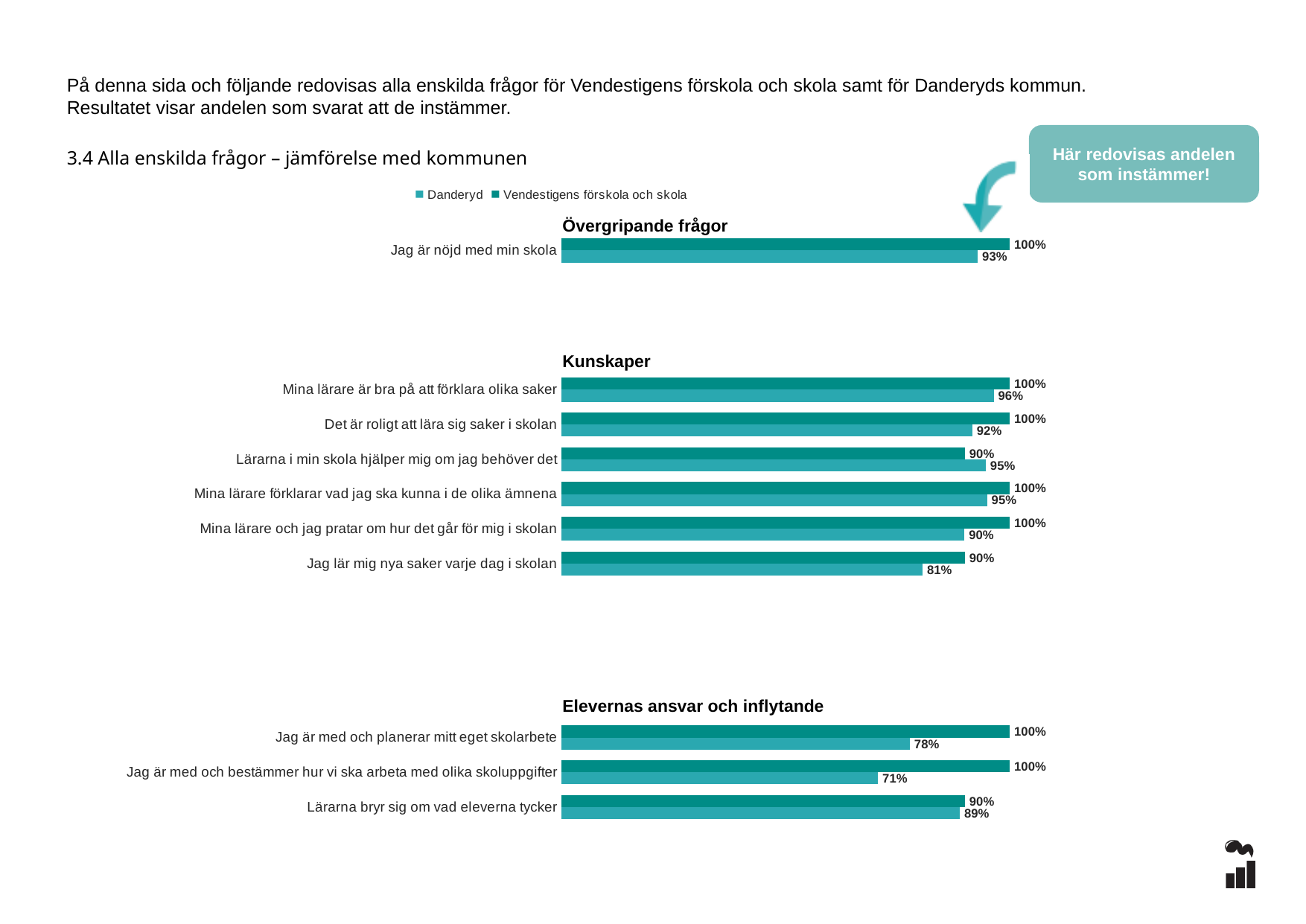
In the 'Elevernas ansvar och inflytande' chart, which question has the lowest Danderyd value? Jag är med och bestämmer hur vi ska arbeta med olika skoluppgifter In the 'Kunskaper' chart, what is the difference between the Vendestigens förskola och skola value and the Danderyd value for 'Jag lär mig nya saker varje dag i skolan'? 9% In the 'Kunskaper' chart, what is the Danderyd value for 'Jag lär mig nya saker varje dag i skolan'? 81% In the 'Elevernas ansvar och inflytande' chart, what is the difference between the Vendestigens förskola och skola value and the Danderyd value for 'Jag är med och planerar mitt eget skolarbete'? 22% In the 'Kunskaper' chart, how many questions are listed? 6 What kind of chart is the 'Kunskaper' chart? Bar chart How many series does the legend list? 2 In the 'Elevernas ansvar och inflytande' chart, which is larger for 'Lärarna bryr sig om vad eleverna tycker': the Vendestigens förskola och skola value or the Danderyd value? Vendestigens förskola och skola In the 'Elevernas ansvar och inflytande' chart, what is the Danderyd value for 'Jag är med och bestämmer hur vi ska arbeta med olika skoluppgifter'? 71% In the 'Kunskaper' chart, which question has the lowest Danderyd value? Jag lär mig nya saker varje dag i skolan In the 'Övergripande frågor' chart, what is the value for Vendestigens förskola och skola for 'Jag är nöjd med min skola'? 100% In the 'Övergripande frågor' chart, what is the value for Danderyd for 'Jag är nöjd med min skola'? 93%